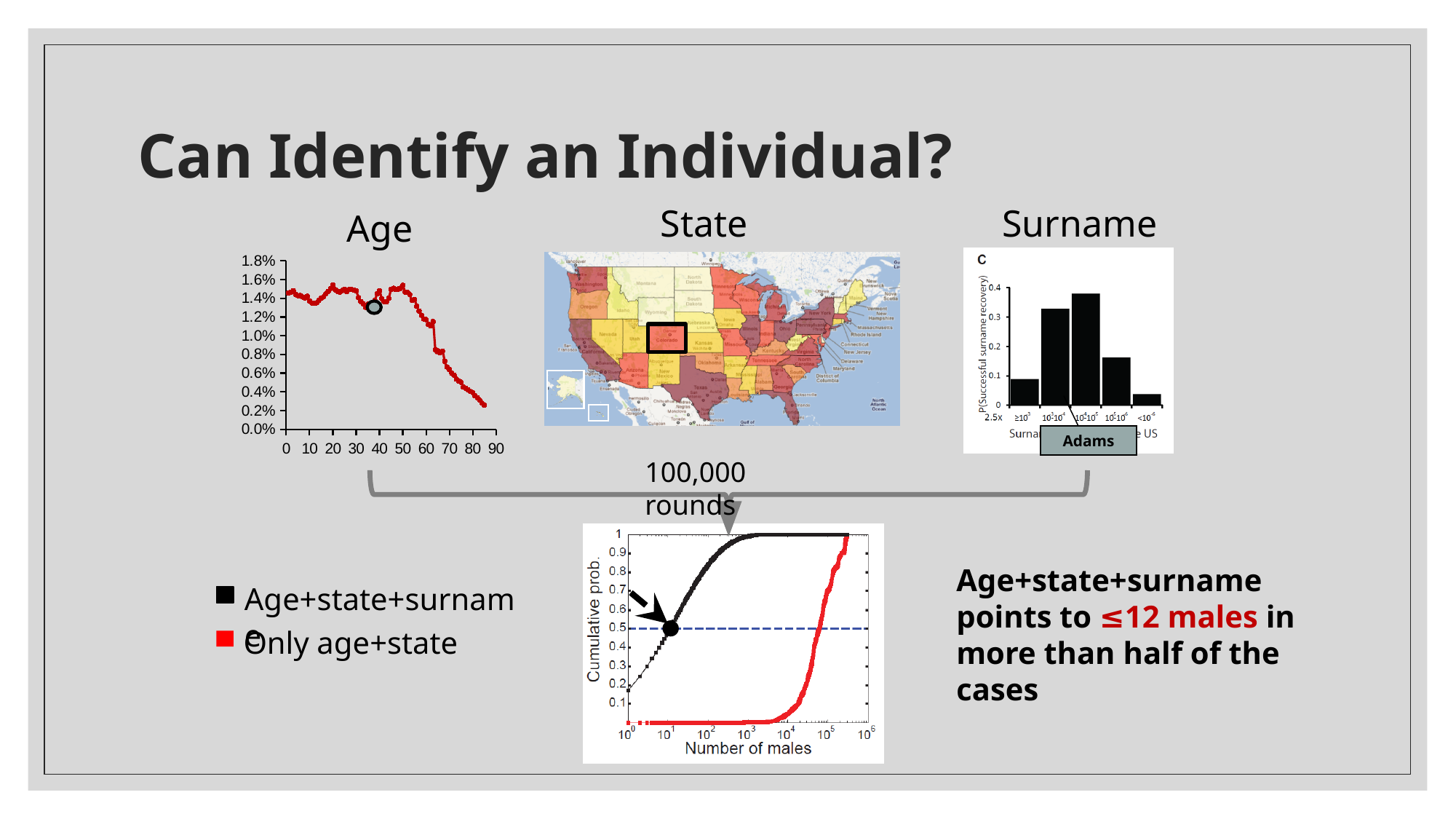
In the Surname chart, which is larger, the bar for 10^3-10^4 or the bar for 10^5-10^6? 10^3-10^4 What kind of chart is the Surname chart? bar chart In the Age chart, do the values rise or fall between age 60 and age 85? fall How many bars does the Surname chart have? 5 In the Surname chart, which category has the lowest bar? <10^6 How many series does the legend of the bottom Cumulative prob. chart list? 2 In the bottom Cumulative prob. chart, at 10^3 males, which series has the higher value, Age+state+surname or Only age+state? Age+state+surname In the Age chart, is the value at age 80 greater or less than 0.6%? less In the Age chart, is the value at age 20 greater or less than 1.2%? greater In the Surname chart, is the value for 10^5-10^6 greater or less than 0.2? less In the Surname chart, which category has the highest bar? 10^4-10^5